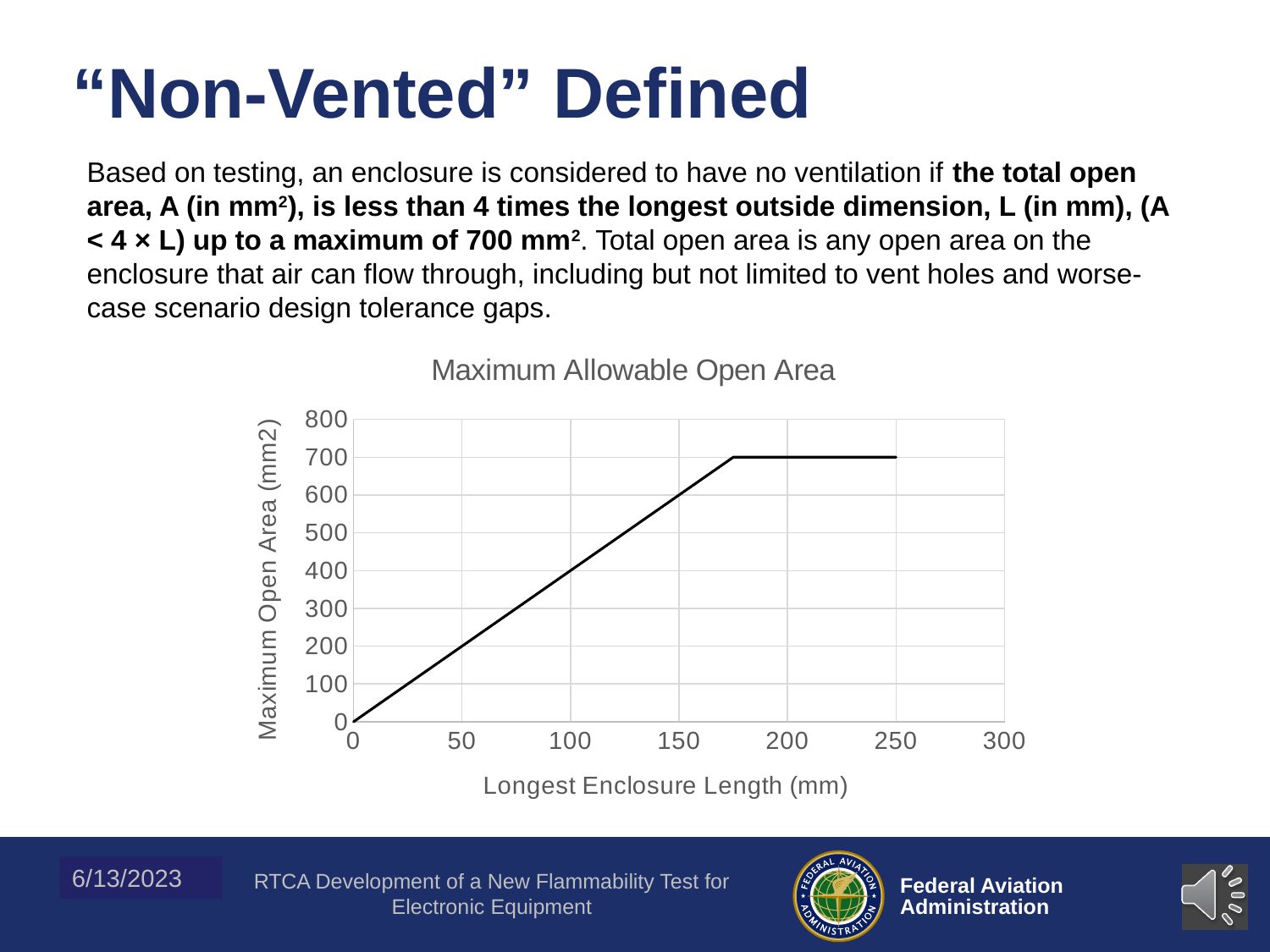
Is the maximum open area at a length of 200 mm greater or less than 600? greater Is the maximum open area at a length of 100 mm greater or less than 300? greater What is the highest value the line reaches on the y axis? 700 Is the maximum open area at a length of 50 mm greater or less than 300? less What is the label of the x axis of the chart? Longest Enclosure Length (mm) At what longest enclosure length does the plotted line end? 250 Does the maximum open area rise or fall as the longest enclosure length increases from 0 to 150 mm? rise What is the maximum open area value at a longest enclosure length of 250 mm? 700 What is the title of the chart? Maximum Allowable Open Area What kind of chart is shown on the slide? line chart Which has the larger maximum open area: a length of 100 mm or a length of 200 mm? 200 mm What is the maximum open area value at a longest enclosure length of 0 mm? 0